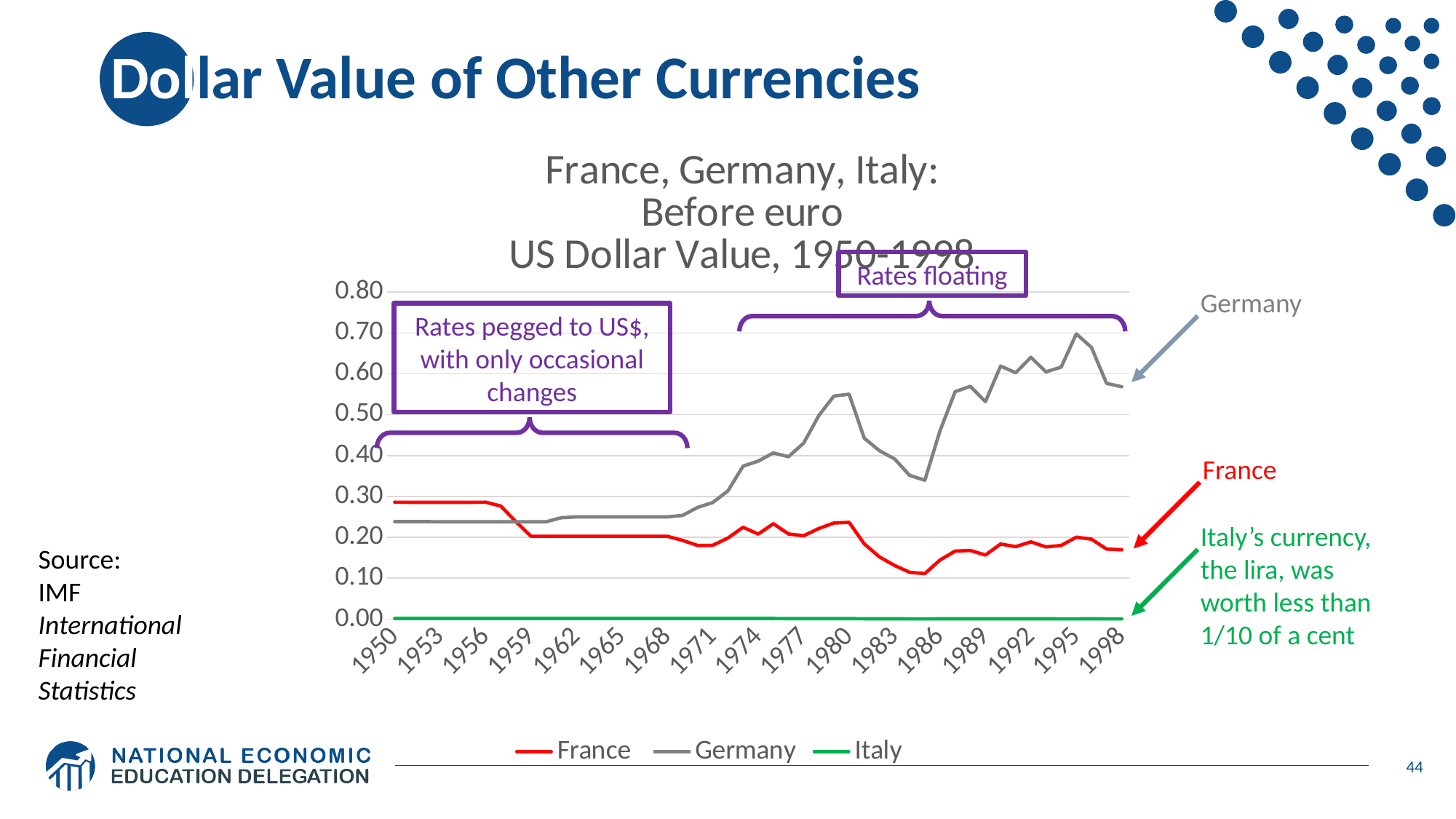
Which series are listed in the chart's legend? France, Germany, Italy Does the Germany line rise or fall overall from 1950 to 1998? rise How many series does the chart's legend list? 3 How many year labels are shown on the x axis of the chart? 17 Is the value for France in 1986 greater or less than 0.20? less Which series has the lowest values across the whole period? Italy Which series has the highest value in 1998? Germany What colour is the Germany line in the chart? grey Is the value for Germany in 1950 greater or less than 0.30? less What kind of chart is shown on the slide? line chart Is the value for Germany in 1995 greater or less than 0.60? greater In 1998, which is larger: the value for Germany or the value for France? Germany